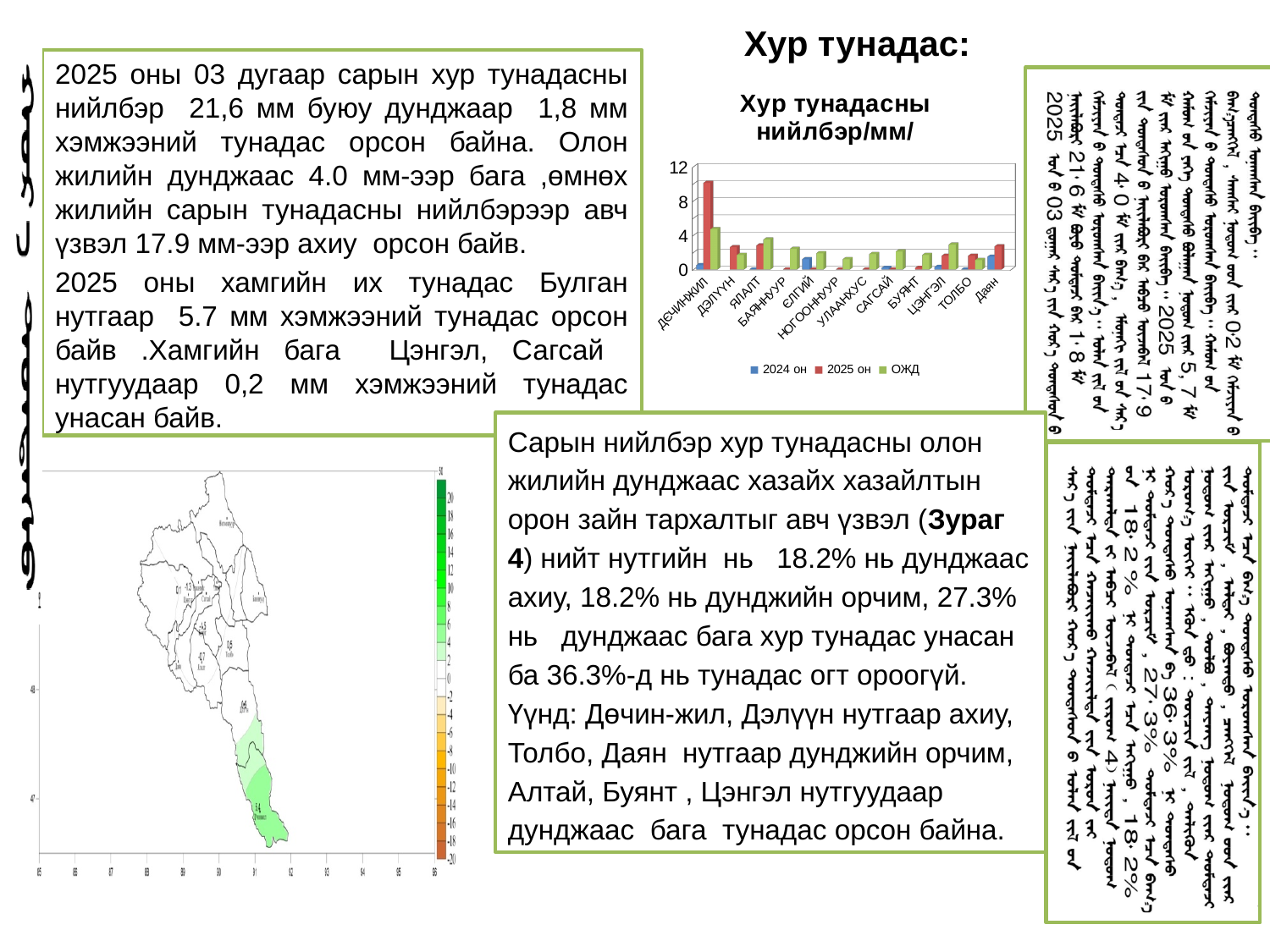
In the "Хур тунадасны нийлбэр/мм/" chart, is the ОЖД value for ДӨЧИНЖИЛ greater or less than 4? greater What is the title of the bar chart on the slide? Хур тунадасны нийлбэр/мм/ In the "Хур тунадасны нийлбэр/мм/" chart, which is larger for ДӨЧИНЖИЛ: the 2025 он value or the ОЖД value? 2025 он How many categories are shown on the x axis of the "Хур тунадасны нийлбэр/мм/" chart? 12 In the "Хур тунадасны нийлбэр/мм/" chart, which category has the highest value for the 2025 он series? ДӨЧИНЖИЛ What are the legend entries of the "Хур тунадасны нийлбэр/мм/" chart? 2024 он, 2025 он, ОЖД In the "Хур тунадасны нийлбэр/мм/" chart, which category has the highest value for the ОЖД series? ДӨЧИНЖИЛ In the "Хур тунадасны нийлбэр/мм/" chart, which has the larger 2025 он value: ДӨЧИНЖИЛ or ДЭЛҮҮН? ДӨЧИНЖИЛ In the "Хур тунадасны нийлбэр/мм/" chart, is the 2025 он value for ДӨЧИНЖИЛ greater or less than 8? greater What kind of chart is "Хур тунадасны нийлбэр/мм/"? bar chart In the "Хур тунадасны нийлбэр/мм/" chart, is the 2025 он value for ДЭЛҮҮН greater or less than 4? less How many series does the legend of the "Хур тунадасны нийлбэр/мм/" chart list? 3